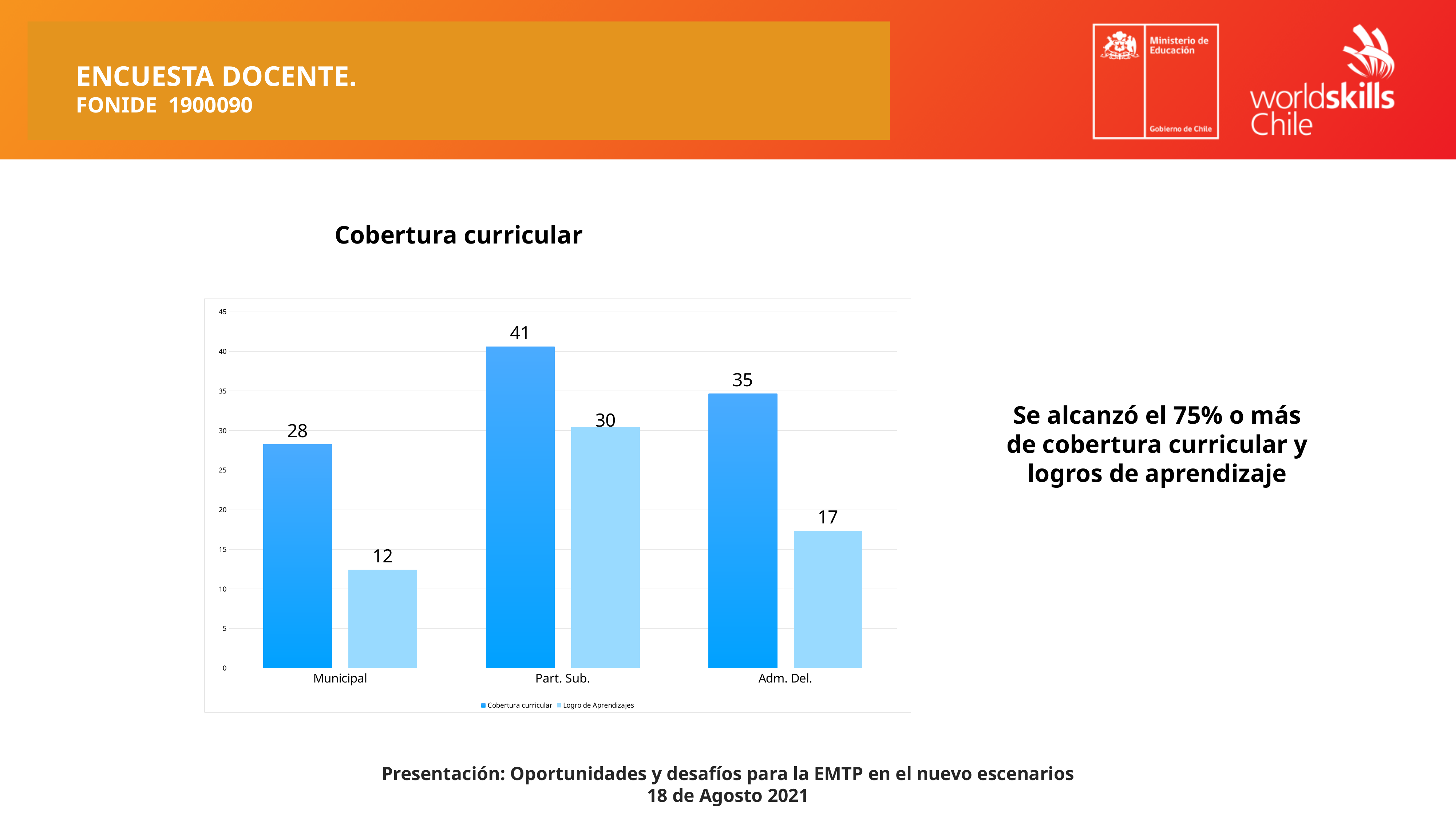
What is the difference between Cobertura curricular and Logro de Aprendizajes for Municipal? 16 What is the value of Logro de Aprendizajes for Part. Sub.? 30 How many categories are shown on the x axis? 3 What is the value of Logro de Aprendizajes for Adm. Del.? 17 What is the value of Cobertura curricular for Municipal? 28 Which category has the lowest Logro de Aprendizajes value? Municipal Is the Cobertura curricular value for Adm. Del. greater or less than 30? greater Which is larger: Logro de Aprendizajes for Part. Sub. or Cobertura curricular for Municipal? Logro de Aprendizajes for Part. Sub. What is the difference between the Cobertura curricular values for Part. Sub. and Adm. Del.? 6 What type of chart is shown on the slide? Bar chart How many series does the legend list? 2 Which category has the highest Cobertura curricular value? Part. Sub.